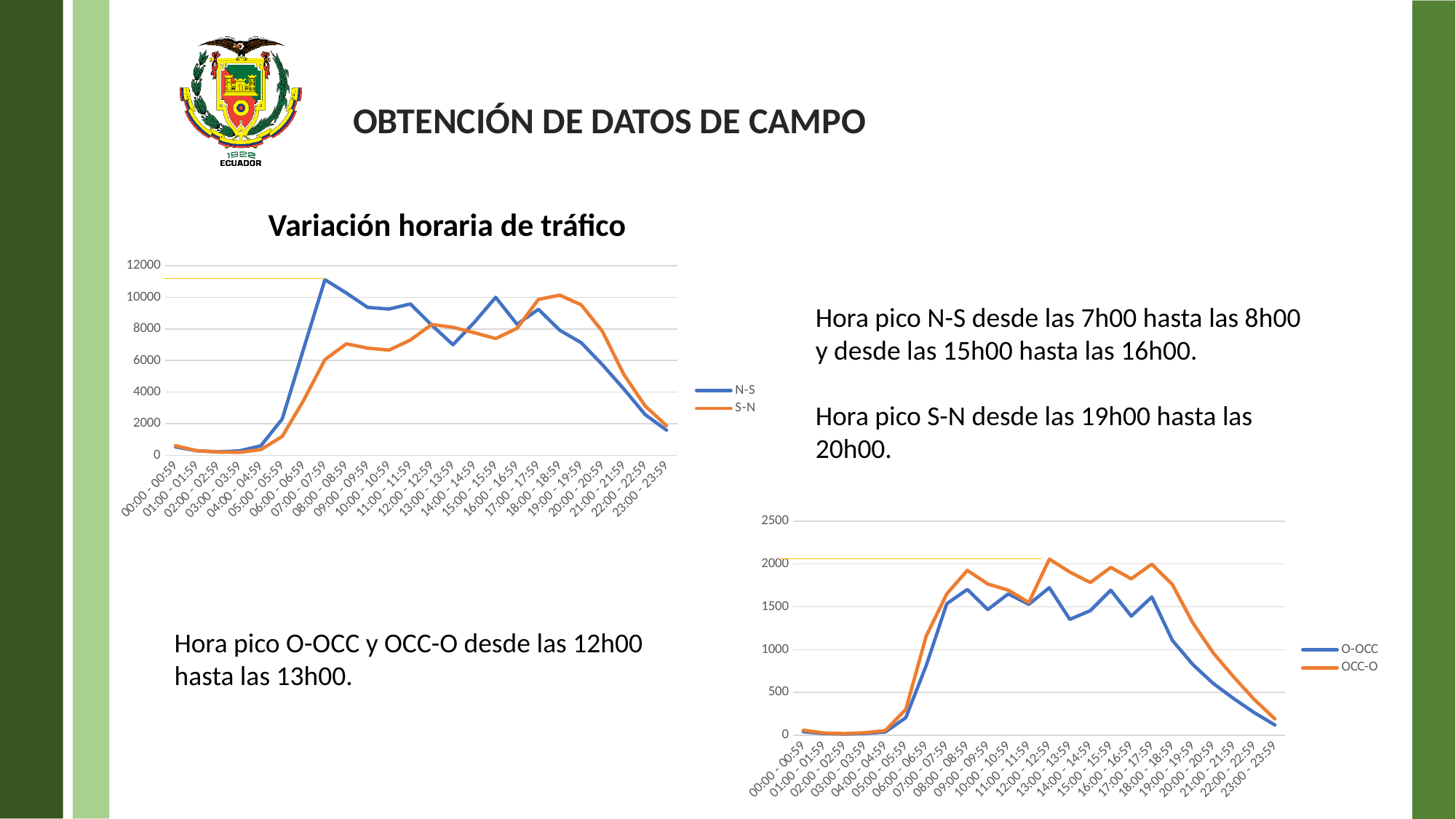
In the chart at the bottom right of the slide, which series does the legend list in orange? OCC-O In the 'Variación horaria de tráfico' chart, at which hour interval does the S-N series reach its highest value? 18:00 - 18:59 In the 'Variación horaria de tráfico' chart, is the S-N value for 07:00 - 07:59 greater or less than 8000? less In the 'Variación horaria de tráfico' chart, is the N-S value for 07:00 - 07:59 greater or less than 10000? greater In the 'Variación horaria de tráfico' chart, does the N-S series rise or fall from 18:00 - 18:59 to 23:00 - 23:59? fall In the 'Variación horaria de tráfico' chart, at which hour interval does the N-S series reach its highest value? 07:00 - 07:59 In the chart at the bottom right of the slide, which series is higher at 13:00 - 13:59, O-OCC or OCC-O? OCC-O How many series does the legend of the 'Variación horaria de tráfico' chart list? 2 In the 'Variación horaria de tráfico' chart, which series is higher at 18:00 - 18:59, N-S or S-N? S-N How many hourly categories are shown on the x axis of the 'Variación horaria de tráfico' chart? 24 What kind of chart is the 'Variación horaria de tráfico' chart? line chart